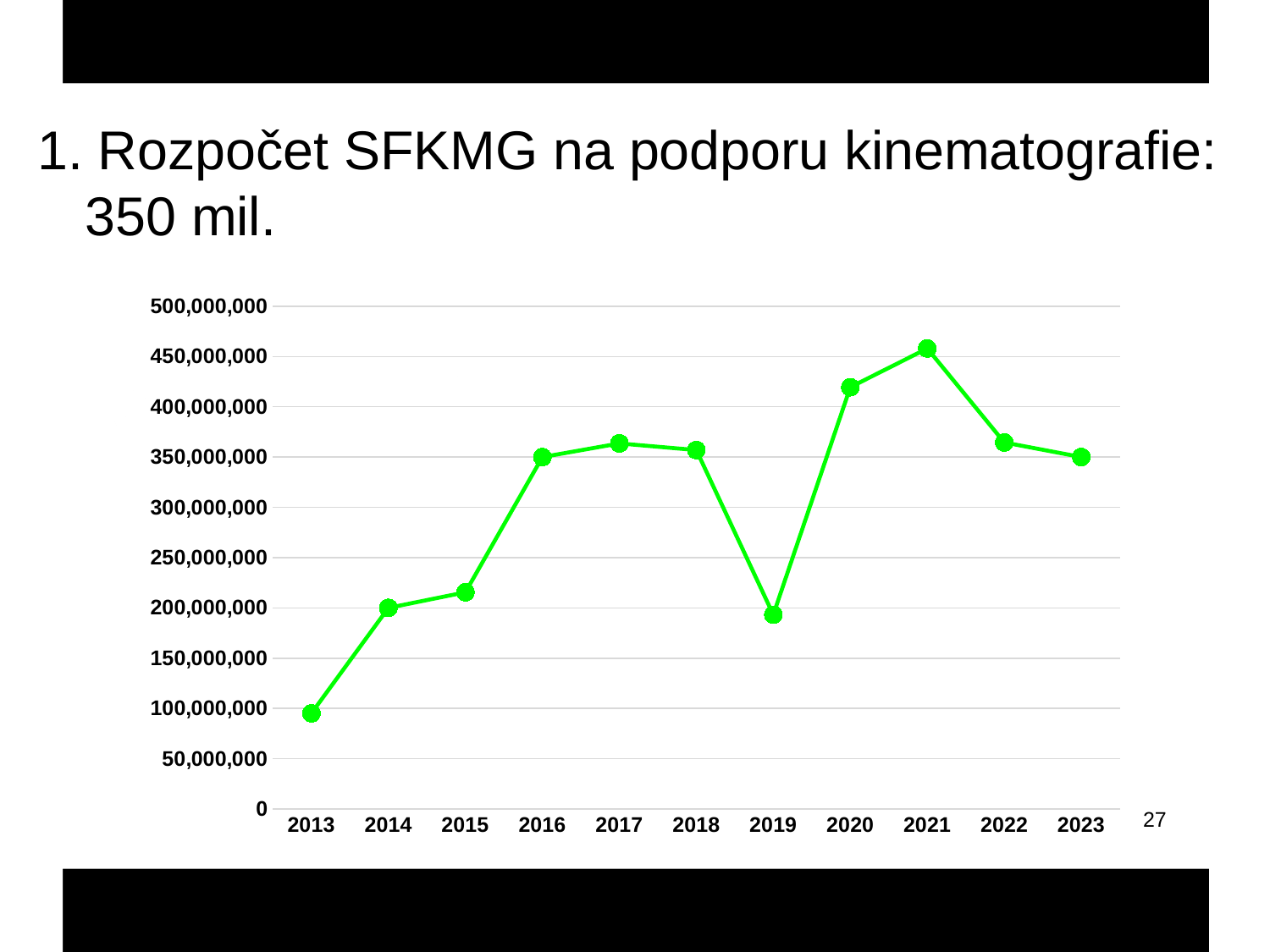
Which year has the larger value, 2020 or 2022? 2020 How many years are plotted on the x axis of the chart? 11 Is the value for 2020 greater or less than 400,000,000? greater Is the value for 2015 greater or less than 200,000,000? greater What kind of chart is shown on the slide? line chart Which year has the highest value in the chart? 2021 Which year has the lowest value in the chart? 2013 Do the values rise or fall from 2013 to 2016? rise Which year has the larger value, 2015 or 2019? 2015